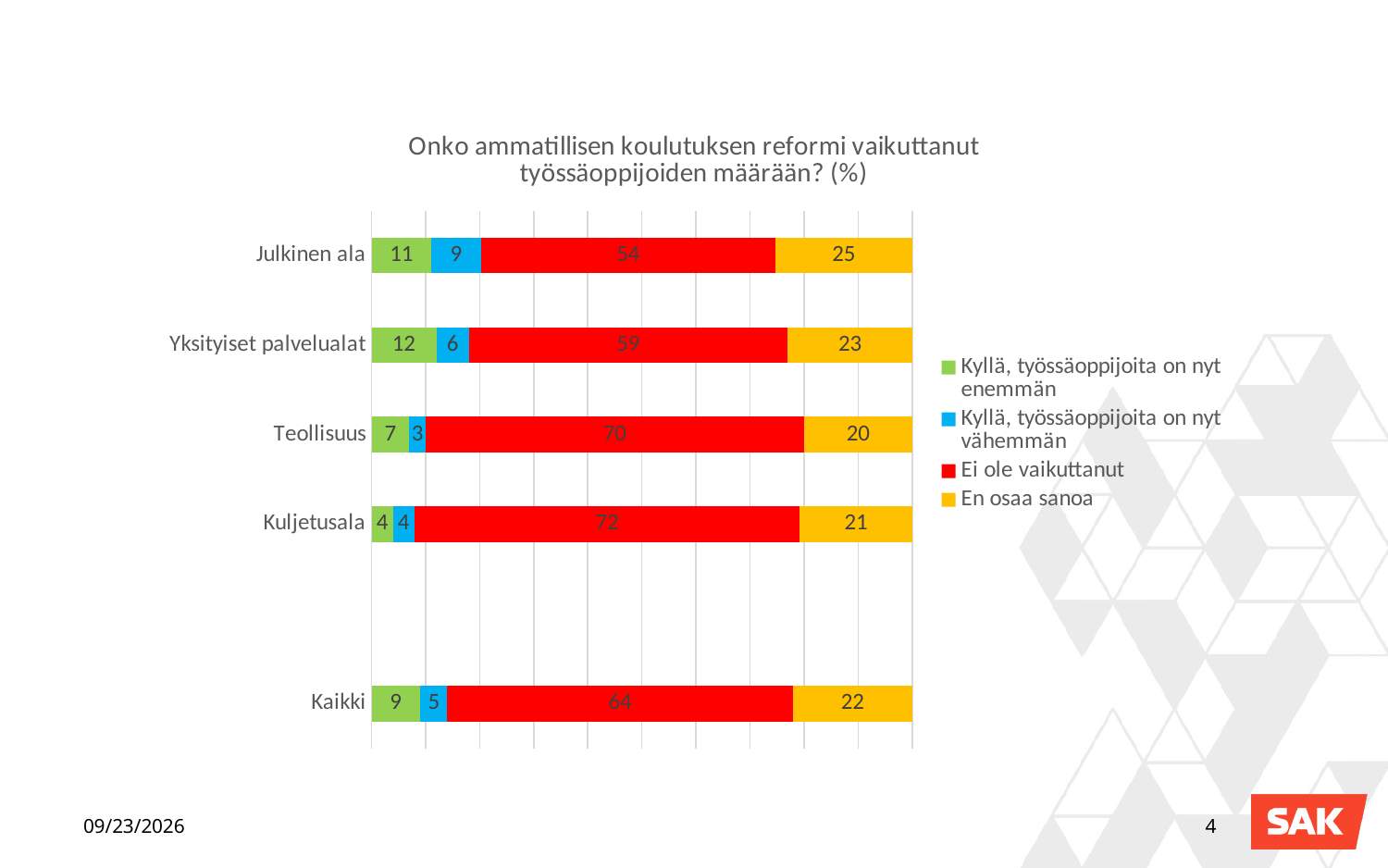
What is the value of "Kyllä, työssäoppijoita on nyt enemmän" for Yksityiset palvelualat? 12 How many categories are shown on the chart? 5 What is the value of "Ei ole vaikuttanut" for Teollisuus? 70 Which is larger: the "En osaa sanoa" value for Julkinen ala or for Teollisuus? Julkinen ala What is the total of the stacked bar for Teollisuus? 100 Which category has the lowest value for "Kyllä, työssäoppijoita on nyt enemmän"? Kuljetusala Which category has the highest value for "Ei ole vaikuttanut"? Kuljetusala What is the difference between the "Ei ole vaikuttanut" values for Kuljetusala and Julkinen ala? 18 What is the value of "En osaa sanoa" for Julkinen ala? 25 How many series does the legend list? 4 What kind of chart is shown on the slide? Stacked bar chart What is the value of "Kyllä, työssäoppijoita on nyt vähemmän" for Kaikki? 5